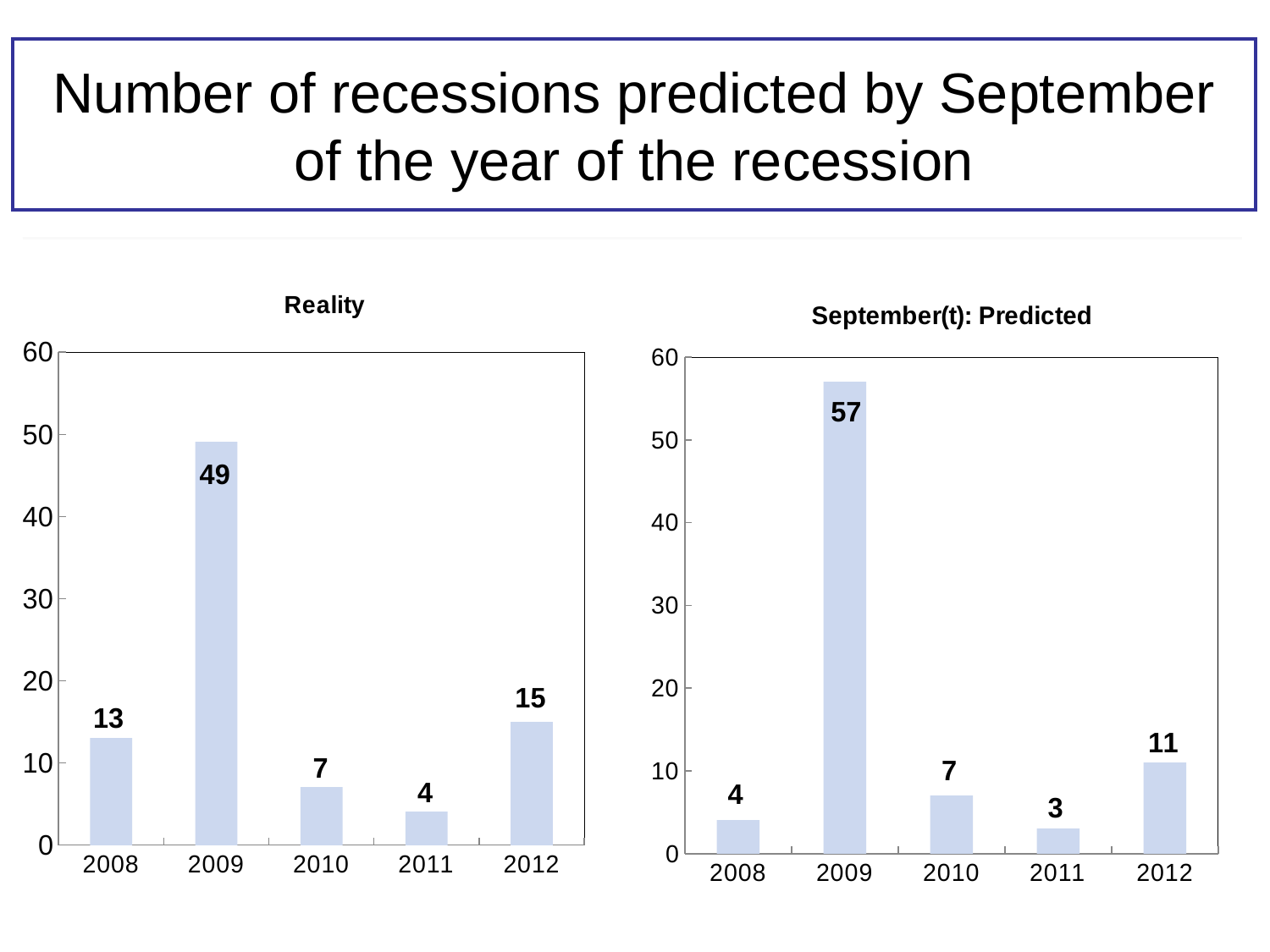
In the "September(t): Predicted" chart, what is the difference between the values for 2009 and 2012? 46 What kind of chart is the "September(t): Predicted" chart? bar chart How many years are shown on the x axis of the "Reality" chart? 5 What is the title of the chart on the left of the slide? Reality In the "September(t): Predicted" chart, what is the value for 2011? 3 In the "Reality" chart, is the value for 2009 greater or less than 40? greater In the "Reality" chart, what is the difference between the values for 2012 and 2008? 2 In the "September(t): Predicted" chart, which is larger, the value for 2008 or the value for 2010? 2010 In the "Reality" chart, which year has the lowest value? 2011 In the "Reality" chart, do the values rise or fall from 2009 to 2011? fall In the "Reality" chart, what is the value for 2009? 49 In the "September(t): Predicted" chart, which year has the highest value? 2009